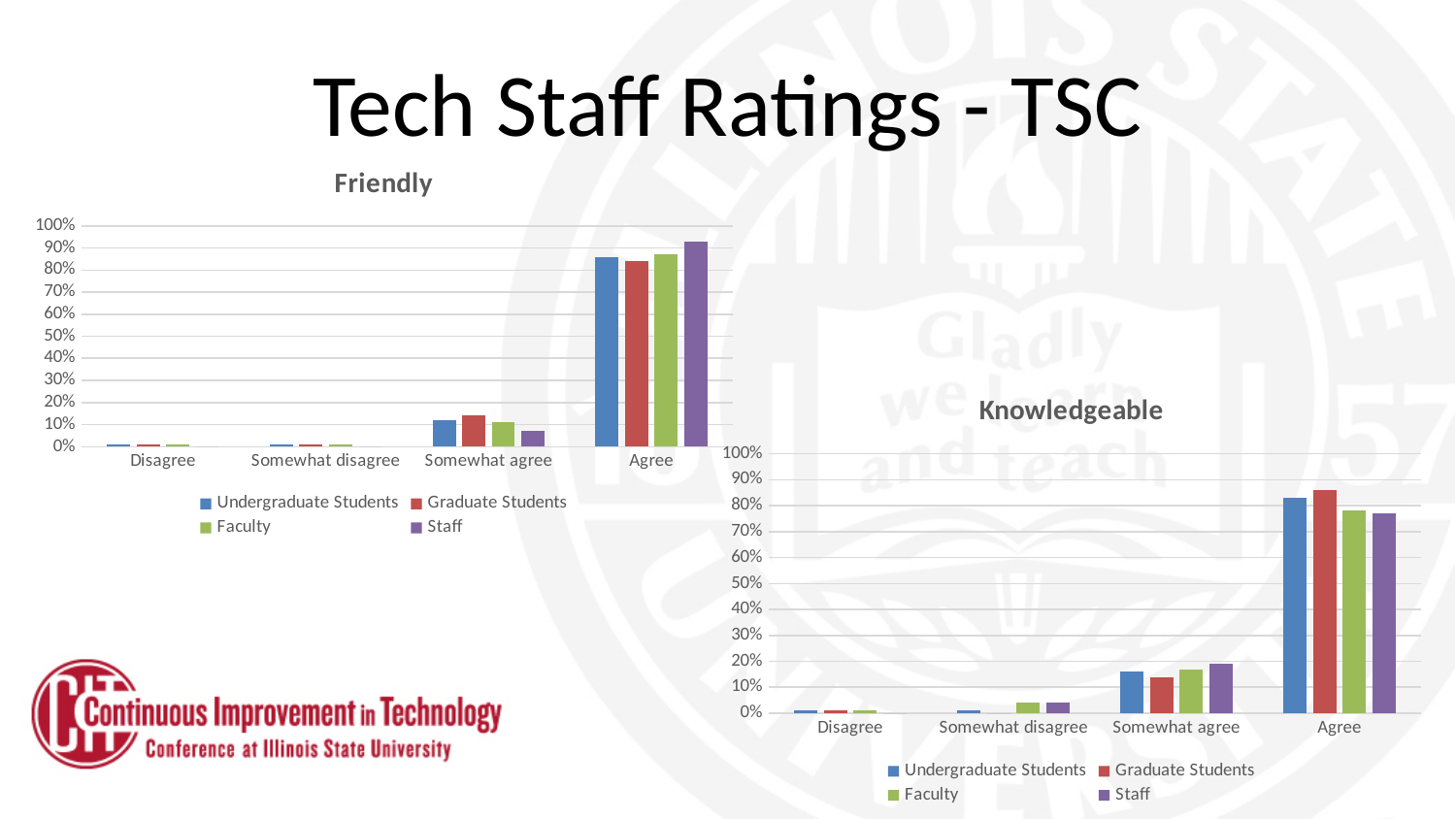
In the "Knowledgeable" chart, which is larger for Somewhat agree: Staff or Graduate Students? Staff In the "Knowledgeable" chart, is the Staff value for Somewhat agree greater or less than 10%? greater In the "Friendly" chart, do the Staff values rise or fall from Disagree to Agree along the x axis? Rise In the "Knowledgeable" chart, is the Faculty value for Agree greater or less than 80%? less How many categories are shown on the x axis of the "Friendly" chart? 4 In the "Friendly" chart, is the Undergraduate Students value for Agree greater or less than 90%? less In the "Knowledgeable" chart, which series has the highest value for Agree? Graduate Students How many series does the legend of the "Knowledgeable" chart list? 4 What kind of chart is the "Friendly" chart? Bar chart In the "Friendly" chart, which series has the highest value for Agree? Staff